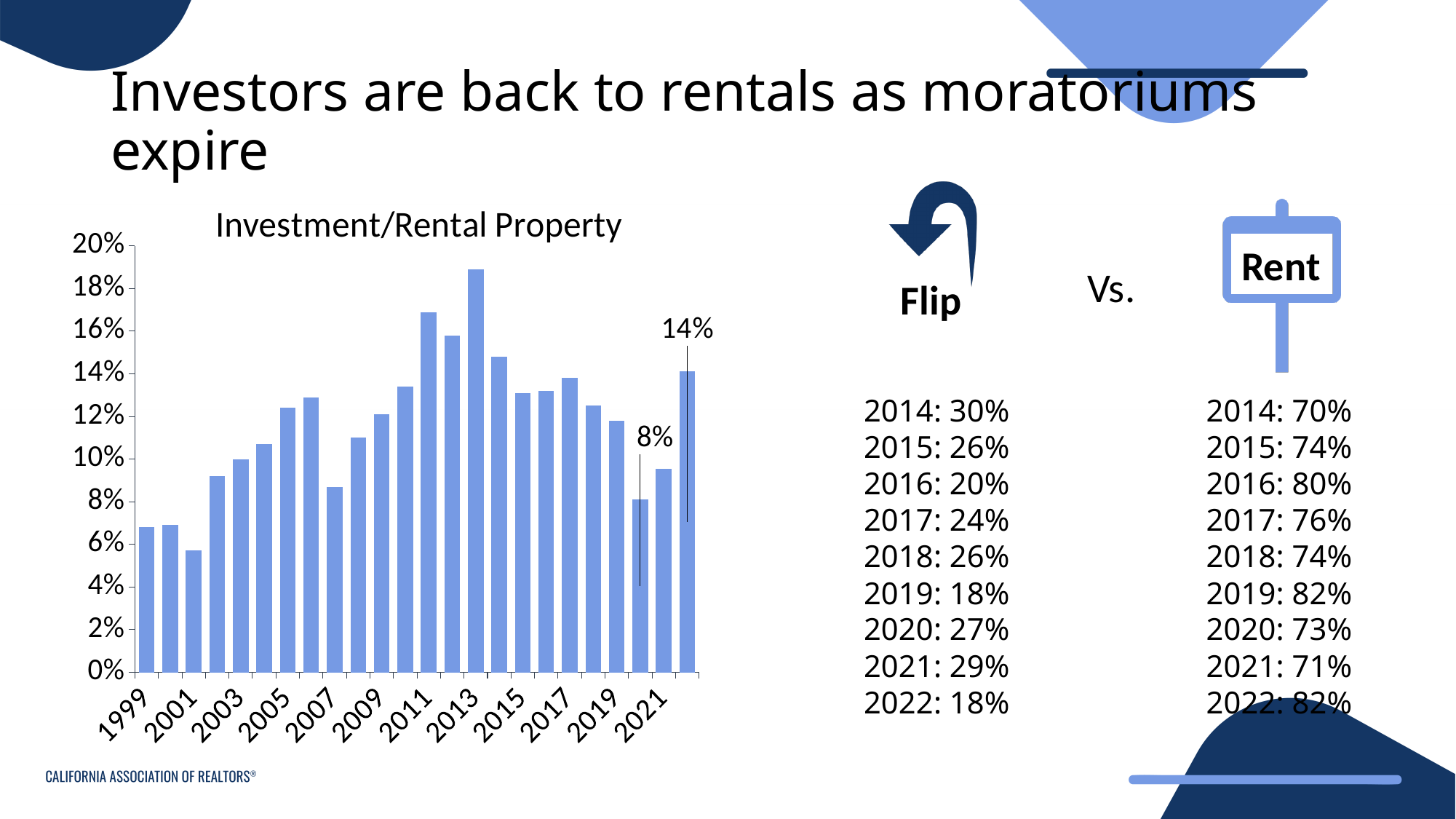
Is the value for 2013 greater or less than 18%? greater What is the labeled value for 2020 in the Investment/Rental Property chart? 8% What is the title of the chart? Investment/Rental Property Which year has the highest bar in the Investment/Rental Property chart? 2013 Which year has the lowest bar in the Investment/Rental Property chart? 2001 What is the labeled value for 2022 in the Investment/Rental Property chart? 14% How many years (bars) are plotted in the Investment/Rental Property chart? 24 What is the difference between the labeled values for 2022 and 2020? 6 percentage points Do the values rise or fall from 2020 to 2022? Rise Is the value for 2007 greater or less than 10%? less Which year has a larger value, 2020 or 2022? 2022 What type of chart is shown on the slide? Bar chart